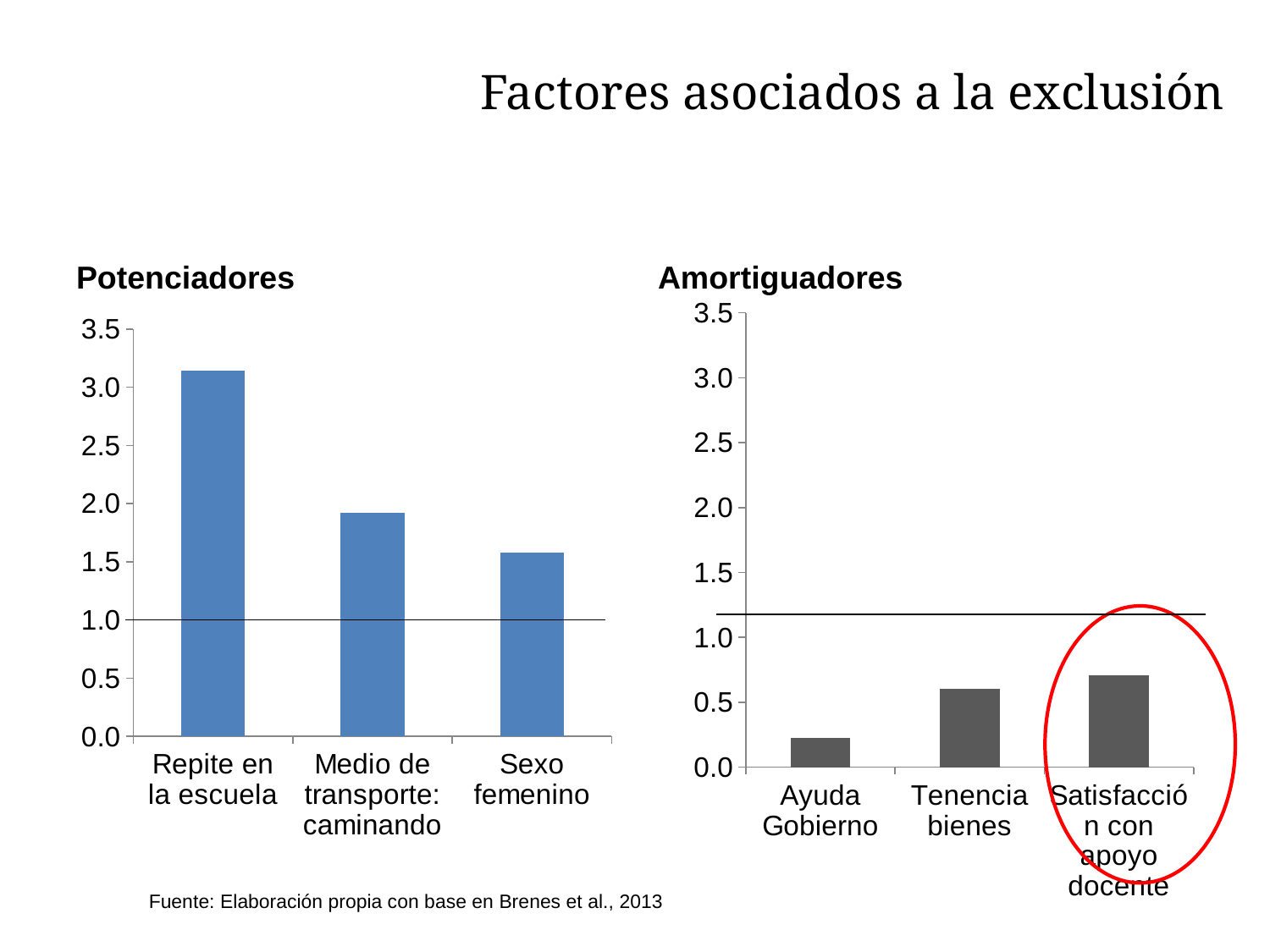
In the Amortiguadores chart, which category has the lowest value? Ayuda Gobierno In the Potenciadores chart, which category has the lowest value? Sexo femenino How many categories are shown in the Potenciadores chart? 3 In the Potenciadores chart, is the value for Sexo femenino greater or less than 2.0? less In the Amortiguadores chart, do the values rise or fall from left to right? rise In the Potenciadores chart, is the value for Repite en la escuela greater or less than 2.5? greater In the Potenciadores chart, do the values rise or fall from left to right? fall What kind of chart is the Potenciadores chart? bar chart In the Amortiguadores chart, which category is circled in red? Satisfacción con apoyo docente In the Potenciadores chart, which category has the highest value? Repite en la escuela In the Potenciadores chart, which is larger: Medio de transporte: caminando or Sexo femenino? Medio de transporte: caminando In the Amortiguadores chart, is the value for Ayuda Gobierno greater or less than 0.5? less